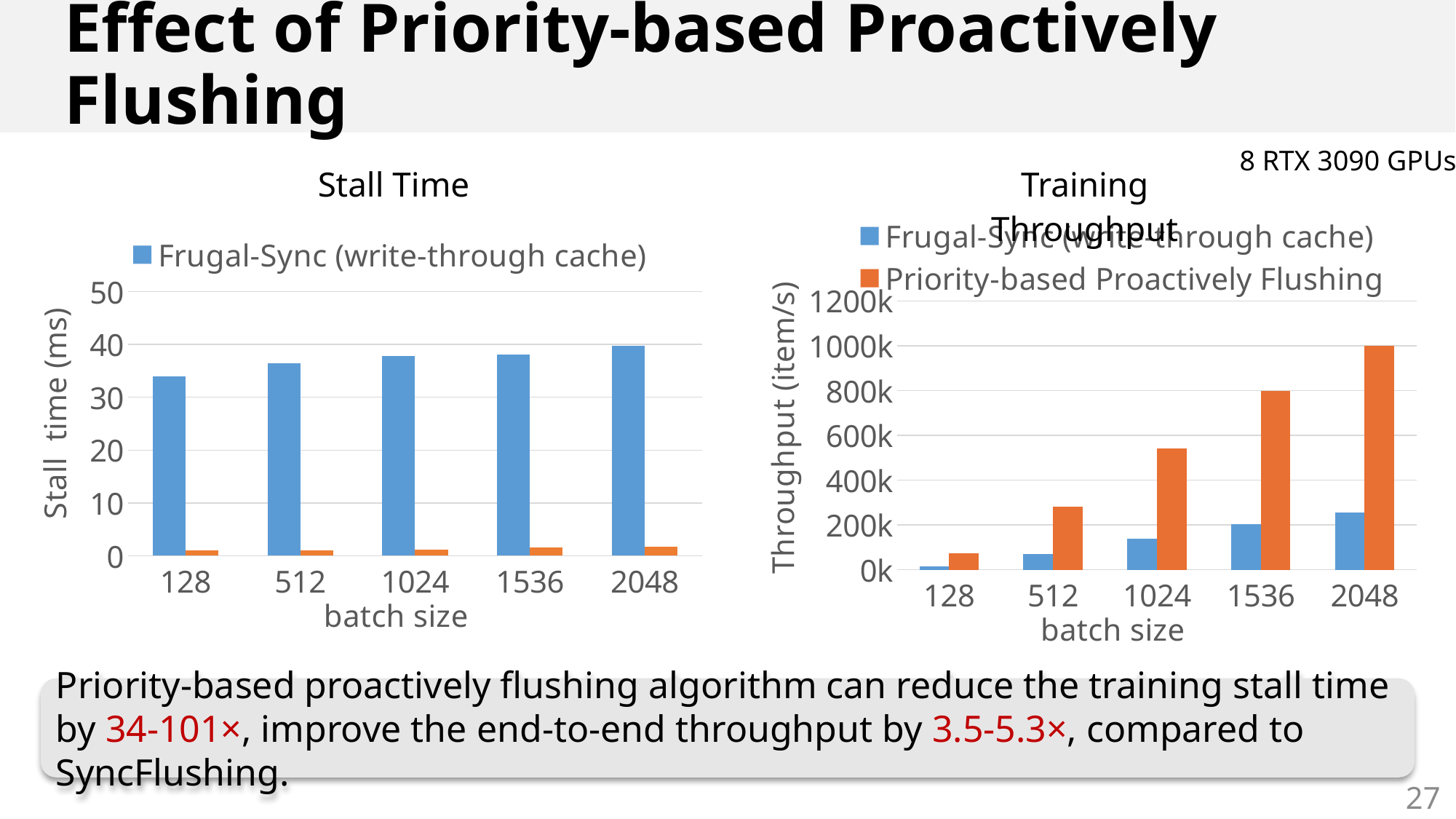
In the Stall Time chart, is the stall time for Priority-based Proactively Flushing at batch size 2048 greater or less than 10? less In the Training Throughput chart, does the Priority-based Proactively Flushing throughput rise or fall as batch size increases? rise In the Stall Time chart, at which batch size is the Frugal-Sync (write-through cache) stall time lowest? 128 In the Stall Time chart, is the stall time for Frugal-Sync (write-through cache) at batch size 128 greater or less than 30? greater How many series does the legend of the Training Throughput chart list? 2 In the Training Throughput chart, is the throughput for Frugal-Sync (write-through cache) at batch size 128 greater or less than 200k? less In the Training Throughput chart, at which batch size is the Priority-based Proactively Flushing throughput highest? 2048 How many batch sizes are shown on the x axis of the Training Throughput chart? 5 What is the y-axis label of the Training Throughput chart? Throughput (item/s) What kind of chart is the Stall Time chart? bar chart In the Stall Time chart, which series has the larger stall time at batch size 1024? Frugal-Sync (write-through cache)